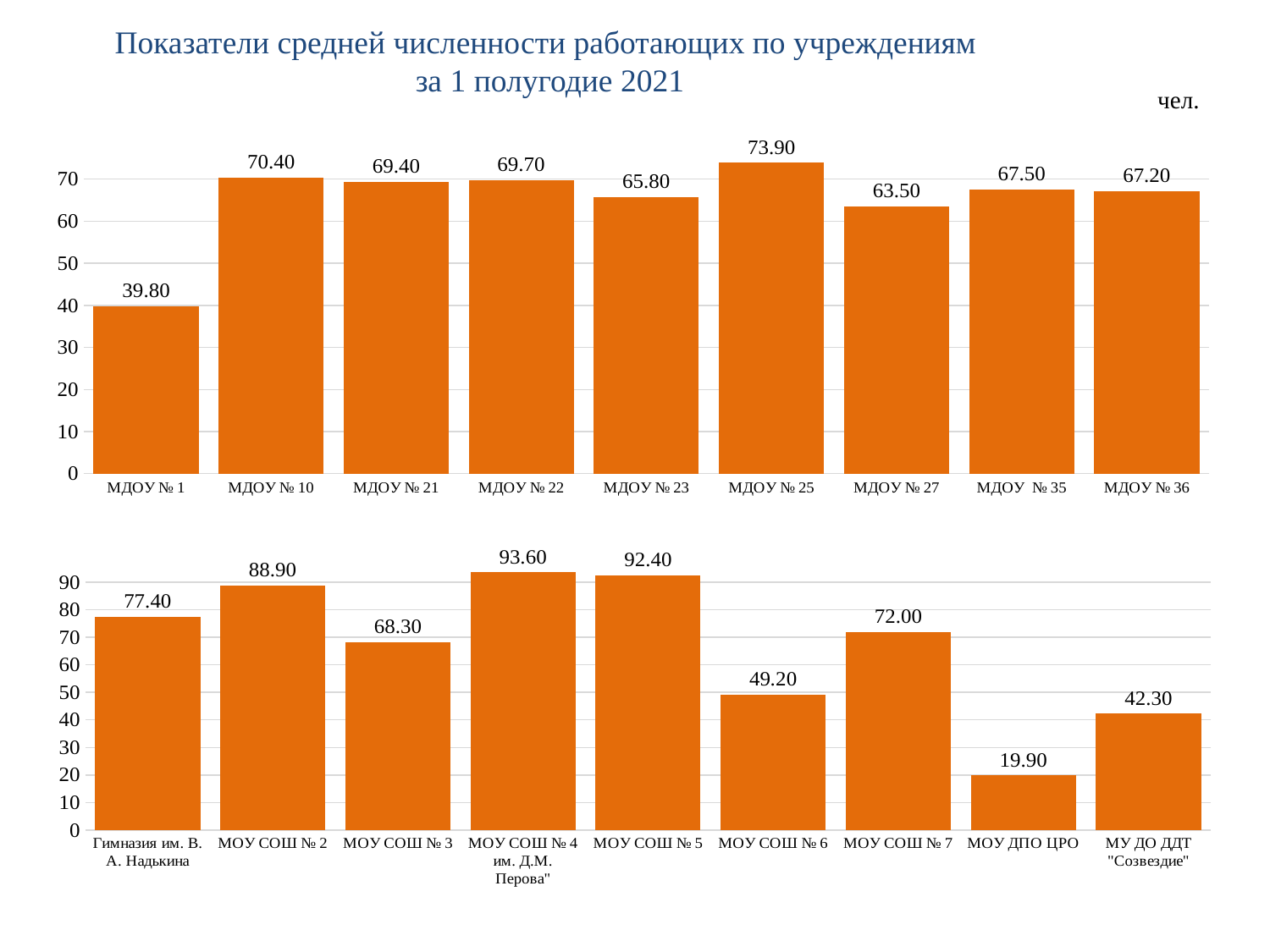
In the bottom chart, which category has the highest value? МОУ СОШ № 4 им. Д.М. Перова" In the top chart, what is the value for МДОУ № 25? 73.90 In the top chart, what is the difference between the values for МДОУ № 10 and МДОУ № 1? 30.60 In the top chart, which category has the lowest value? МДОУ № 1 In the bottom chart, what is the difference between the values for МОУ СОШ № 5 and МОУ СОШ № 6? 43.20 In the bottom chart, which category has the lowest value? МОУ ДПО ЦРО In the bottom chart, which is larger: the value for МОУ СОШ № 2 or the value for МОУ СОШ № 7? МОУ СОШ № 2 In the bottom chart, what is the value for МОУ ДПО ЦРО? 19.90 In the top chart, which category has the highest value? МДОУ № 25 What type of chart is the top chart? Bar chart In the bottom chart, how many categories are shown? 9 In the top chart, how many categories are shown? 9